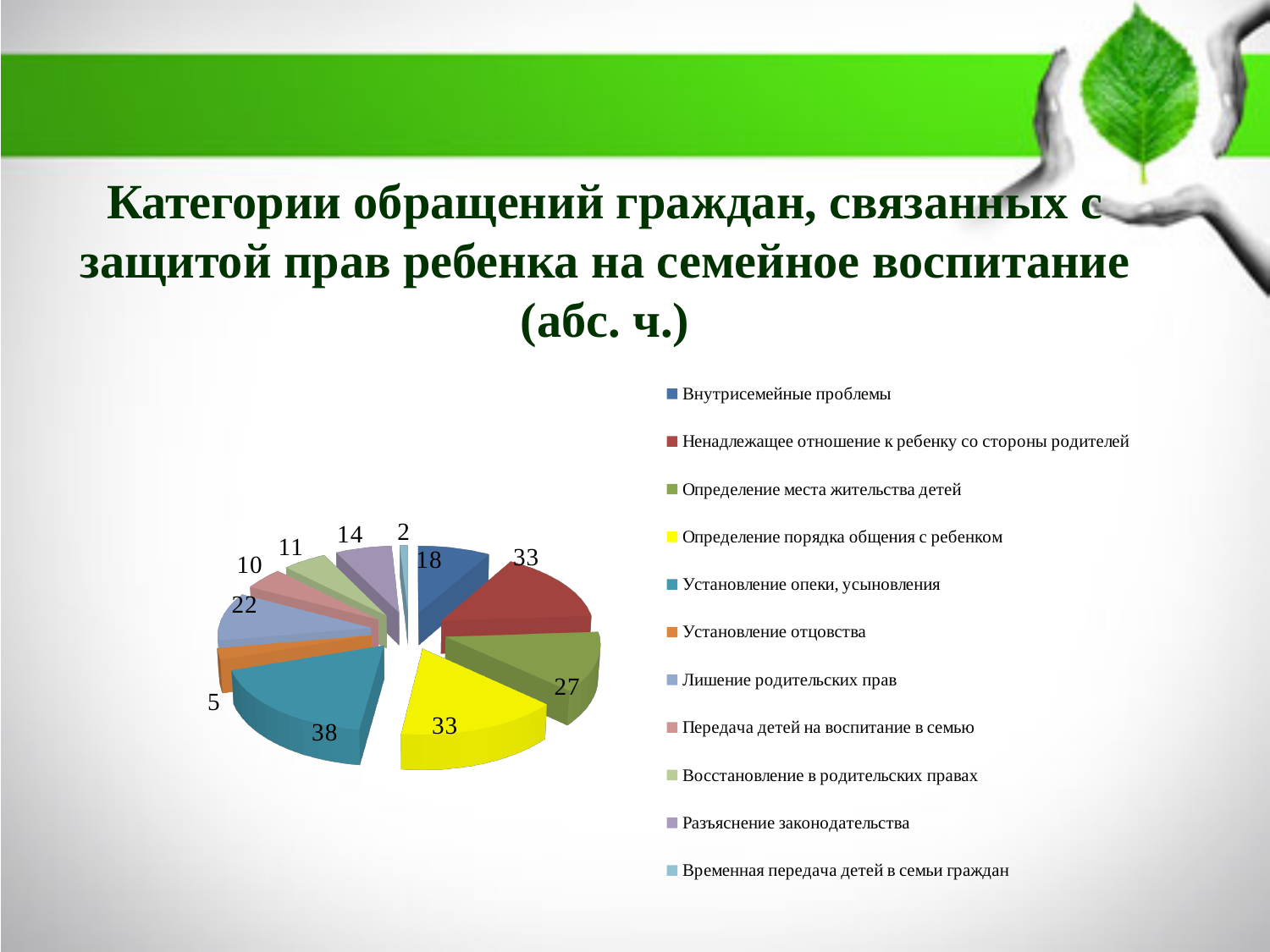
What is the total of all the values shown in the pie chart? 213 What is the value for «Установление опеки, усыновления»? 38 What is the title of the chart on the slide? Категории обращений граждан, связанных с защитой прав ребенка на семейное воспитание (абс. ч.) What is the value for «Установление отцовства»? 5 Which is larger: the value for «Разъяснение законодательства» or the value for «Восстановление в родительских правах»? Разъяснение законодательства How many categories does the legend of the pie chart list? 11 What is the difference between the values for «Установление опеки, усыновления» and «Определение места жительства детей»? 11 What is the value for «Лишение родительских прав»? 22 What kind of chart is shown on the slide? pie chart What is the value for «Внутрисемейные проблемы»? 18 Which category has the largest value in the pie chart? Установление опеки, усыновления Which category has the smallest value in the pie chart? Временная передача детей в семьи граждан